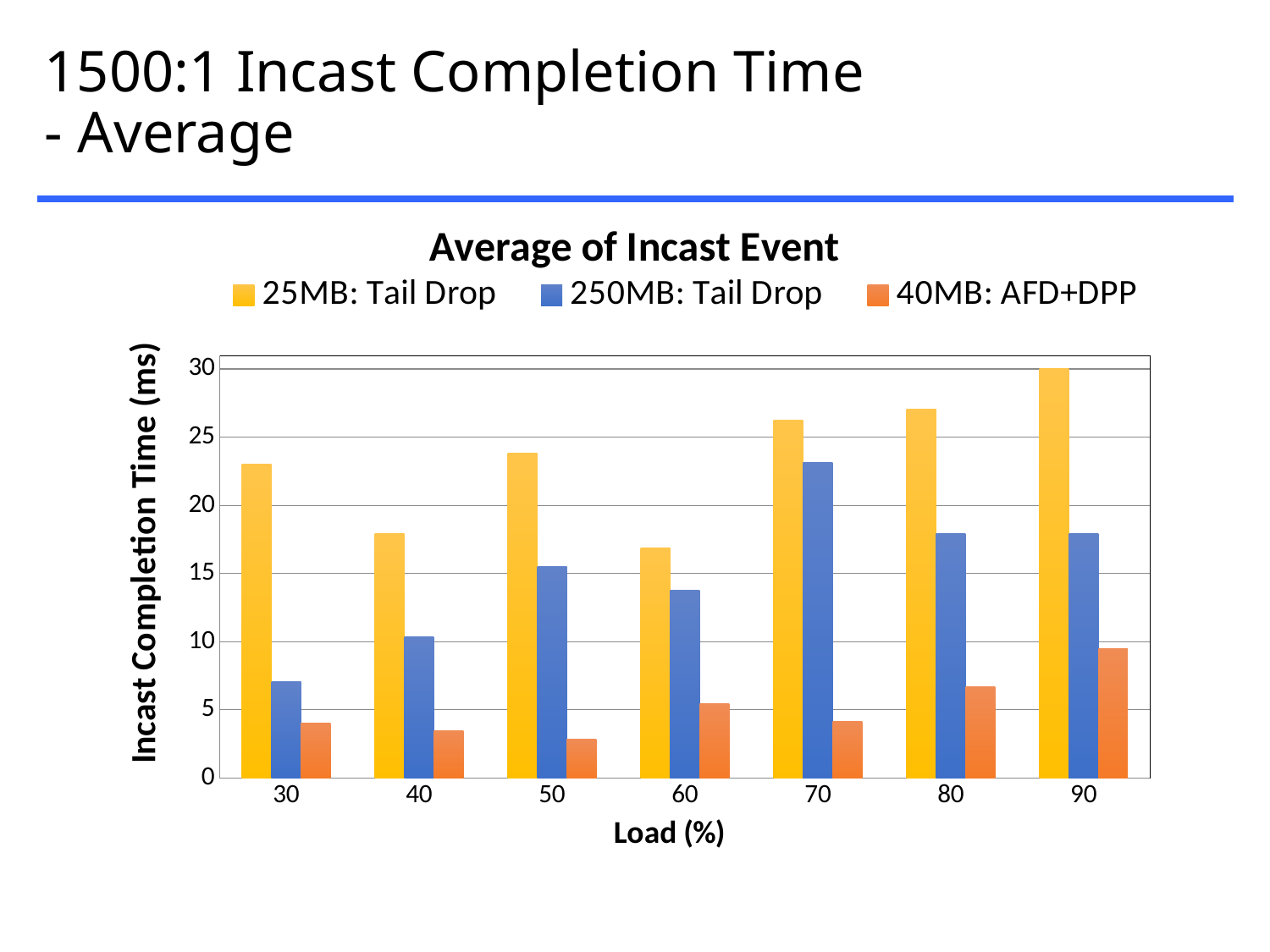
At which load is the 25MB: Tail Drop value highest? 90 Is the value for 25MB: Tail Drop at load 90 greater or less than 25? greater How many load levels are shown on the x axis? 7 Is the value for 250MB: Tail Drop at load 30 greater or less than 10? less At load 70, which is larger: 25MB: Tail Drop or 250MB: Tail Drop? 25MB: Tail Drop How many series does the legend list? 3 Do the 25MB: Tail Drop values rise or fall from load 60 to load 90? rise At which load is the 40MB: AFD+DPP value highest? 90 At which load is the 250MB: Tail Drop value highest? 70 At which load is the 250MB: Tail Drop value lowest? 30 Is the value for 25MB: Tail Drop at load 60 greater or less than 20? less What kind of chart is shown on the slide? bar chart